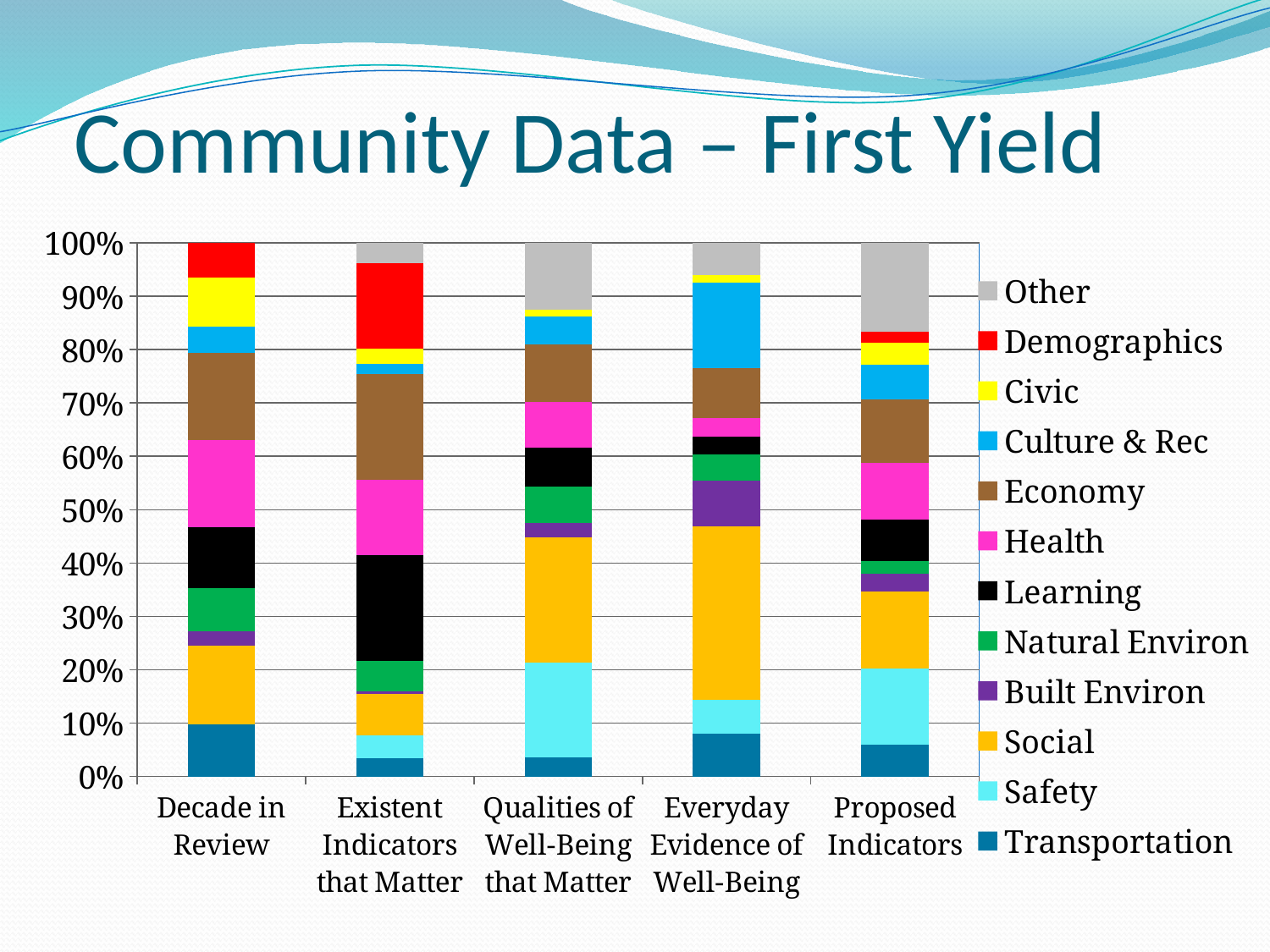
What kind of chart is shown on the slide? stacked bar chart Which category has the largest Culture & Rec segment? Everyday Evidence of Well-Being In Everyday Evidence of Well-Being, is the upper boundary of the Social segment greater or less than 40%? greater Is the Social segment larger in Everyday Evidence of Well-Being or in Decade in Review? Everyday Evidence of Well-Being What is the title of the slide containing the chart? Community Data – First Yield Which series in the legend is shown in red? Demographics Which category has the largest Social segment? Everyday Evidence of Well-Being How many categories are shown along the x axis of the chart? 5 Which category has the largest Learning segment? Existent Indicators that Matter Is the Learning segment larger in Existent Indicators that Matter or in Proposed Indicators? Existent Indicators that Matter How many series does the chart's legend list? 12